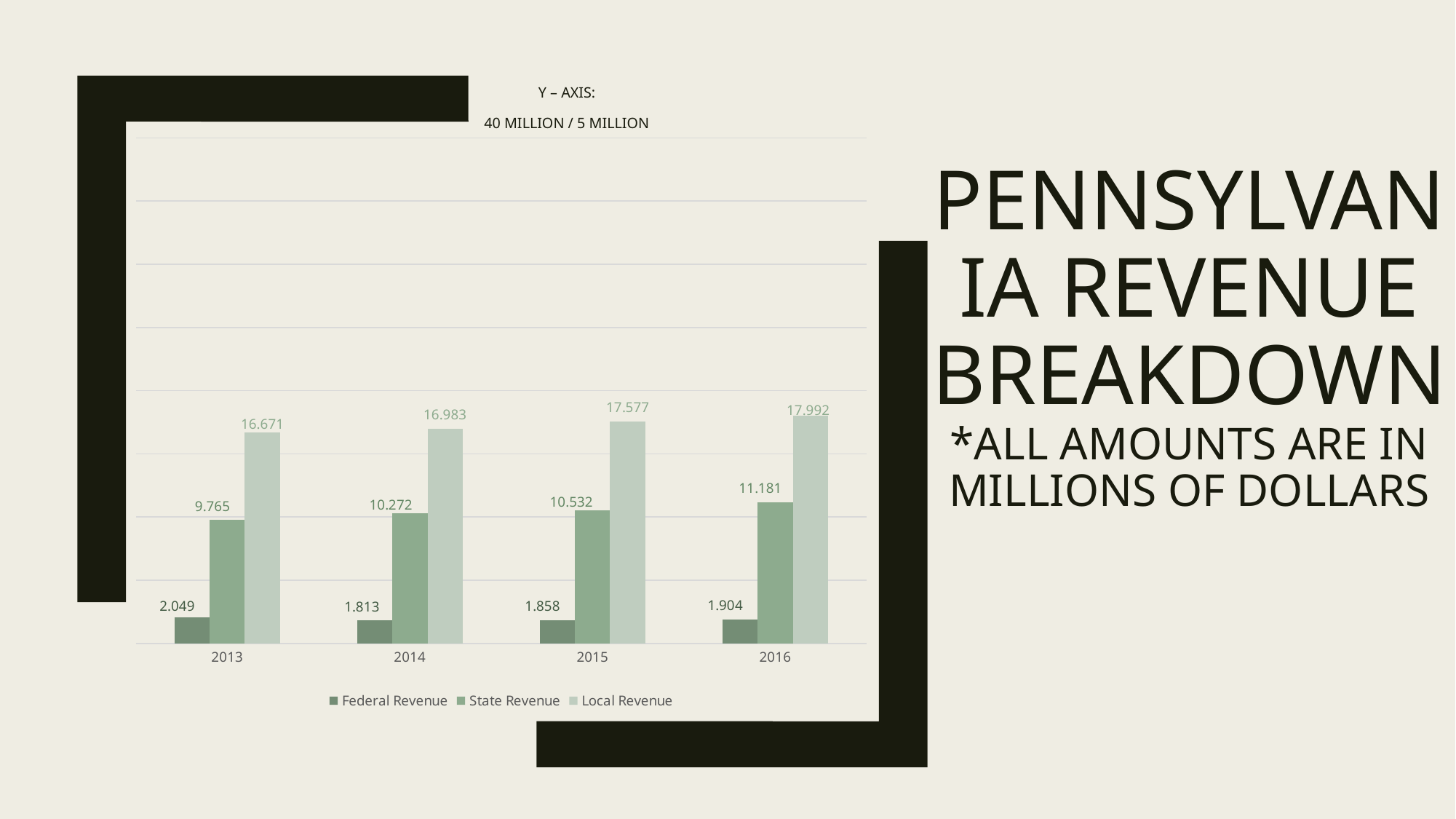
What is the Local Revenue value for 2016? 17.992 What kind of chart is shown on the slide? Bar chart In which year is Local Revenue highest? 2016 Does State Revenue rise or fall from 2013 to 2016? Rise How many series does the legend list? 3 What are the three series listed in the legend? Federal Revenue, State Revenue, Local Revenue How many years are shown on the x axis? 4 In which year is Federal Revenue lowest? 2014 Which is larger: Local Revenue in 2013 or Local Revenue in 2015? Local Revenue in 2015 What is the Federal Revenue value for 2013? 2.049 What is the State Revenue value for 2014? 10.272 What is the difference between State Revenue in 2016 and State Revenue in 2013? 1.416